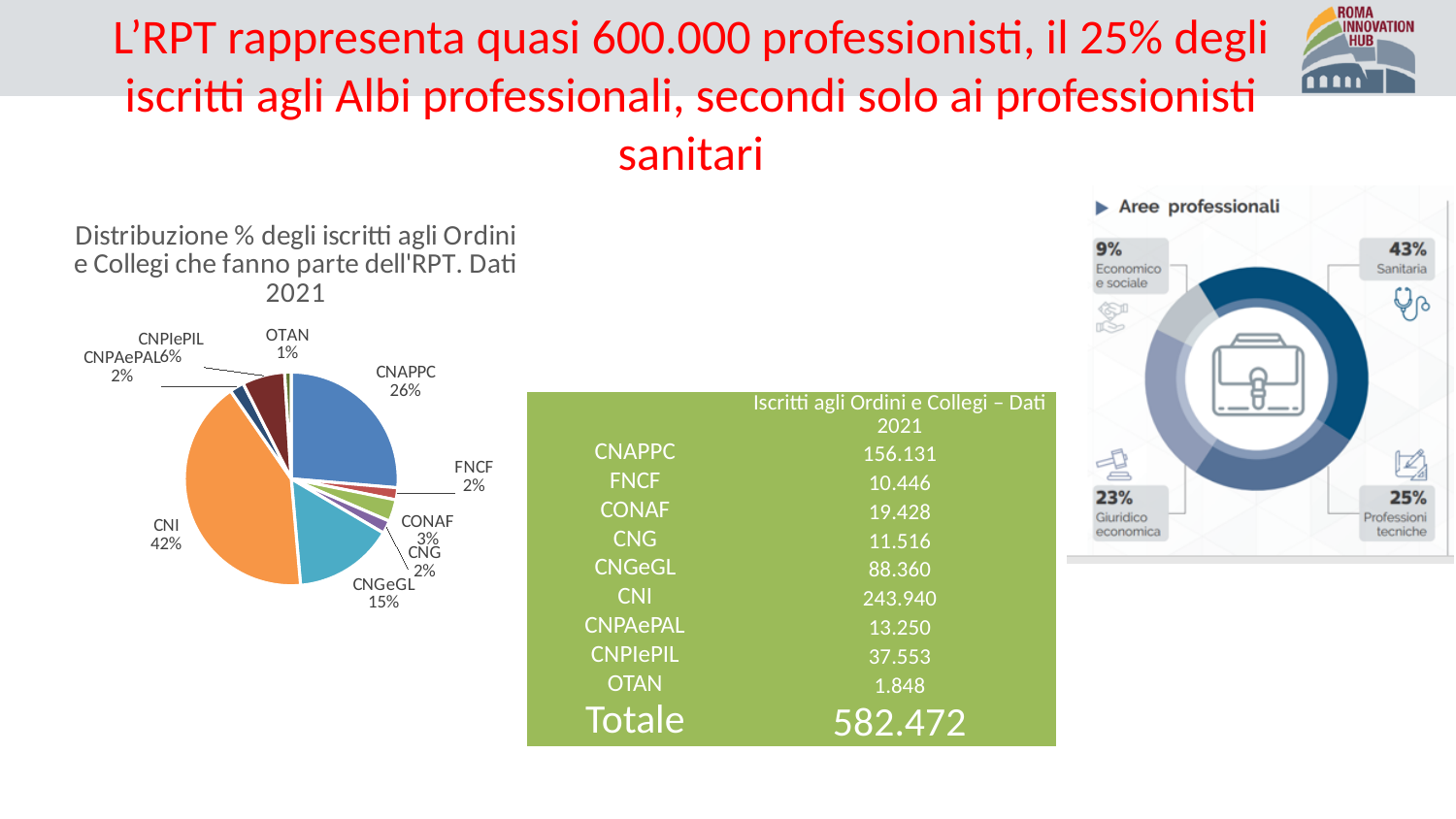
On the pie chart on the left, how many categories (slices) are shown? 9 On the pie chart on the left, which category has the smallest slice? OTAN On the 'Aree professionali' donut chart on the right, what percentage is shown for Professioni tecniche? 25% On the pie chart on the left, what percentage is shown for CNAPPC? 26% On the 'Aree professionali' donut chart on the right, which area has the smallest share? Economico e sociale On the pie chart on the left, what is the difference in percentage points between CNI and CNAPPC? 16 On the pie chart on the left, what percentage is shown for CNGeGL? 15% On the pie chart on the left, which is larger, CNGeGL or CNPIePIL? CNGeGL On the 'Aree professionali' donut chart on the right, what percentage is shown for Sanitaria? 43% On the pie chart 'Distribuzione % degli iscritti agli Ordini e Collegi che fanno parte dell'RPT', what share does CNI have? 42% On the pie chart on the left, which category has the largest slice? CNI What type of chart is used on the left to show the distribution of iscritti agli Ordini e Collegi? Pie chart